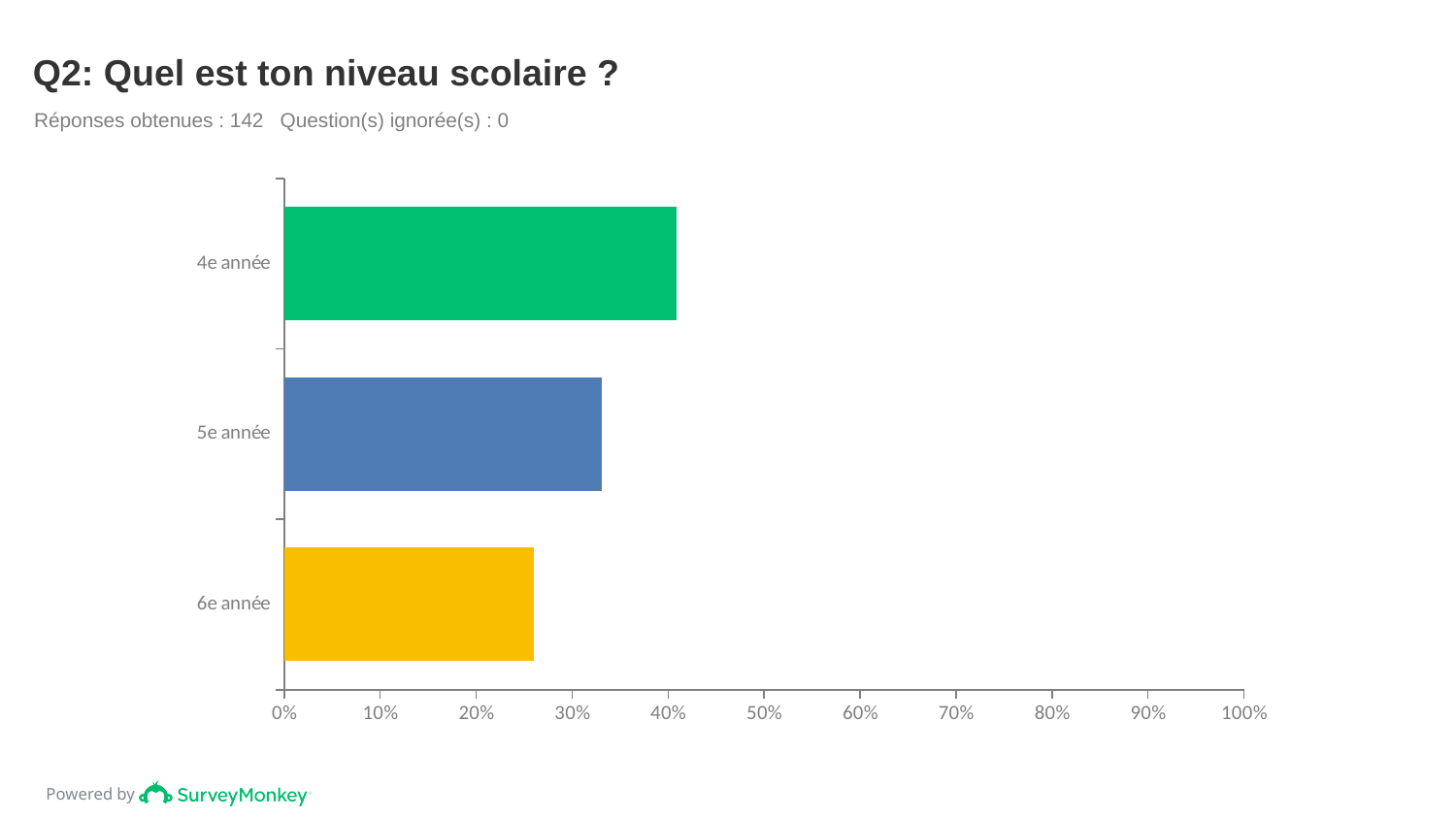
Is the value for 4e année greater or less than 30%? greater How many categories (school levels) are shown in the chart? 3 What is the title of the chart? Q2: Quel est ton niveau scolaire ? Which is larger, the value for 4e année or the value for 5e année? 4e année Which school level has the lowest share of responses? 6e année Is the value for 5e année greater or less than 40%? less Which school level has the highest share of responses? 4e année Is the value for 6e année greater or less than 30%? less What kind of chart is shown on the slide? bar chart Which is larger, the value for 5e année or the value for 6e année? 5e année Do the bar values increase or decrease going from 4e année down to 6e année? decrease